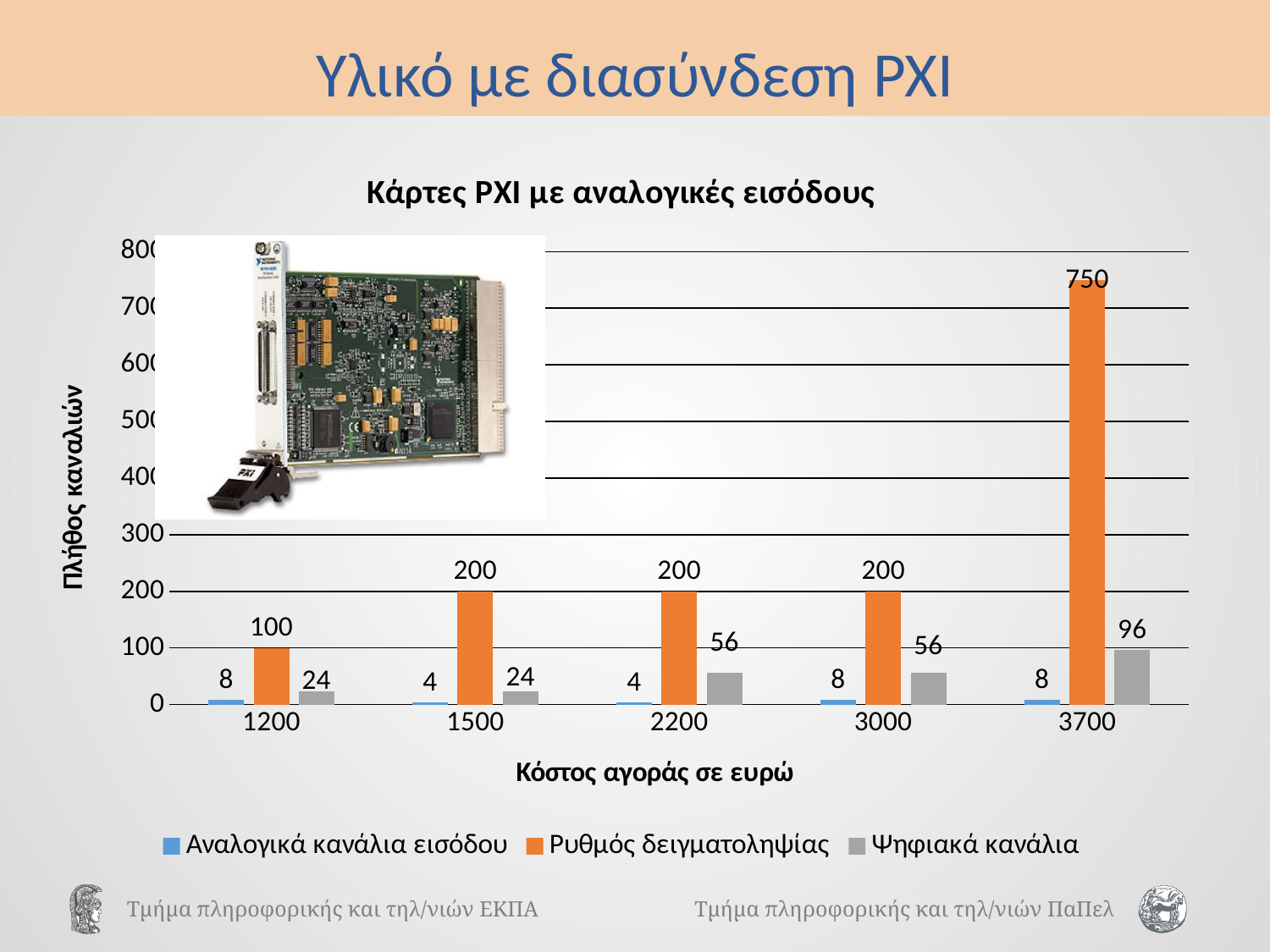
What is the title of the chart? Κάρτες PXI με αναλογικές εισόδους What is the label of the y axis? Πλήθος καναλιών What is the value of Ρυθμός δειγματοληψίας for the 3700 category? 750 How many cost categories are shown on the x axis? 5 What is the difference between the Ψηφιακά κανάλια values for 3700 and 1200? 72 What is the value of Αναλογικά κανάλια εισόδου for the 1500 category? 4 Which cost category has the lowest Ρυθμός δειγματοληψίας value? 1200 What type of chart is shown on the slide? bar chart Which cost category has the highest Ρυθμός δειγματοληψίας value? 3700 What is the value of Ψηφιακά κανάλια for the 2200 category? 56 Which is larger: Ψηφιακά κανάλια for 3000 or Ψηφιακά κανάλια for 1500? 3000 How many series does the legend list? 3